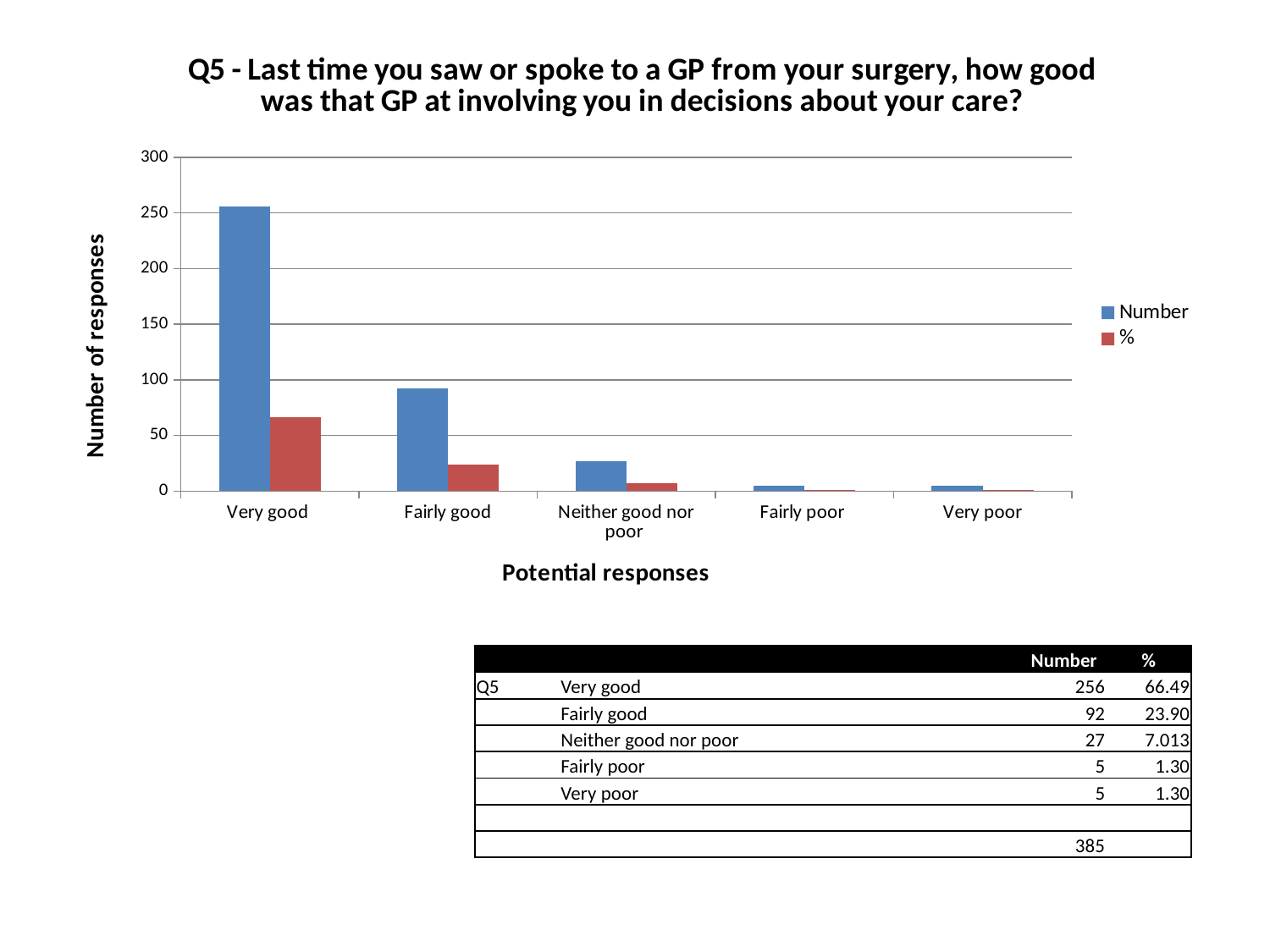
What is the Number value for Fairly good? 92 Which is larger, the Number for Fairly good or the Number for Neither good nor poor? Fairly good What is the difference in Number between Very good and Fairly good? 164 Do the Number values rise or fall moving from Very good to Very poor along the x axis? fall How many series does the chart legend list? 2 What type of chart is shown on the slide? bar chart What is the % value for Neither good nor poor? 7.013 Is the Number value for Very good greater or less than 250? greater Which response category has the highest Number of responses? Very good What is the label of the y axis of the chart? Number of responses What is the Number value for Very good? 256 How many response categories are shown on the x axis of the chart? 5